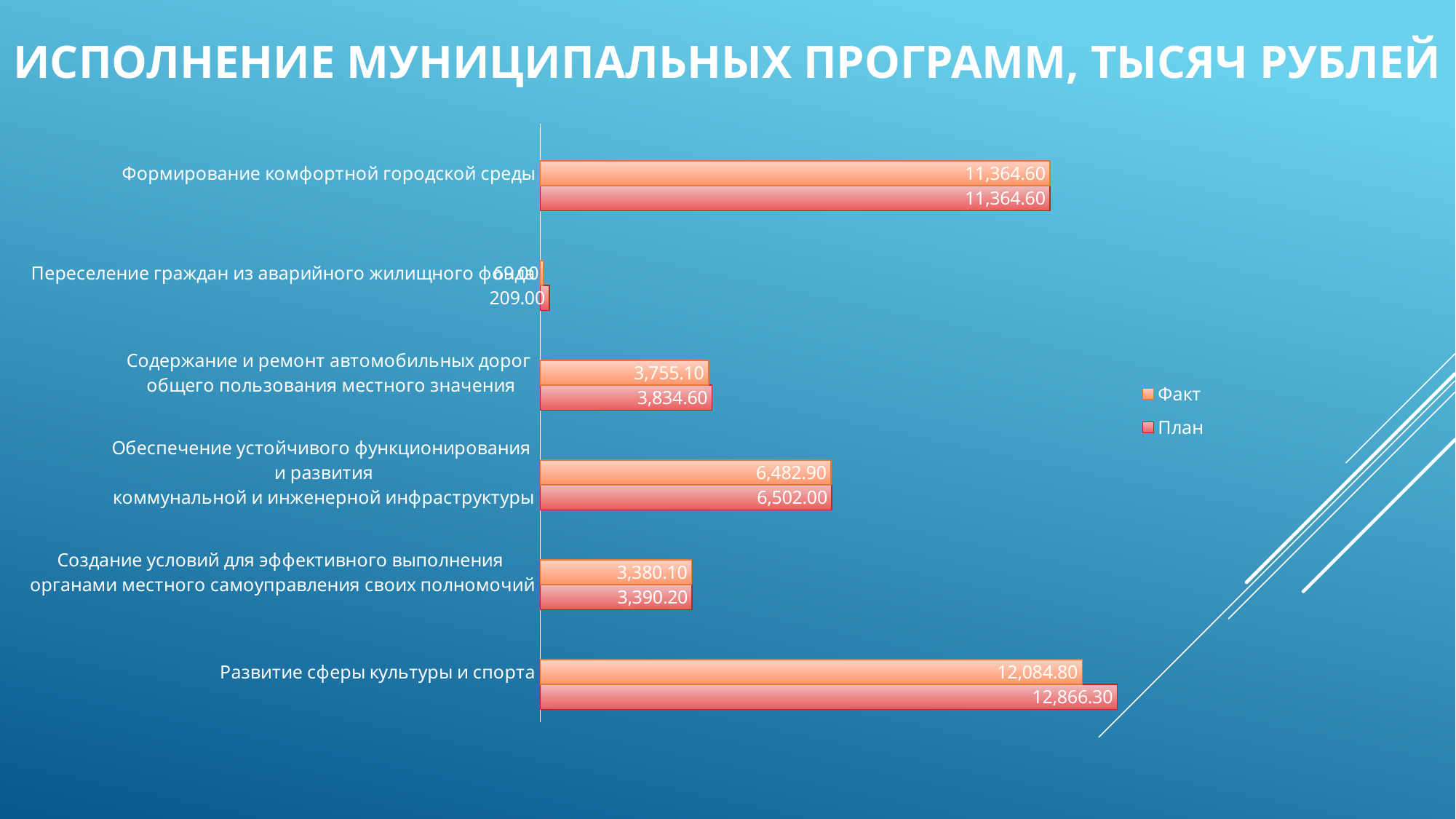
What is the difference between the План and Факт values for Развитие сферы культуры и спорта? 781.50 What is the Факт value for Развитие сферы культуры и спорта? 12,084.80 Which category has the lowest Факт value? Переселение граждан из аварийного жилищного фонда Which category has the highest План value? Развитие сферы культуры и спорта How many categories are shown in the chart? 6 How many series does the legend list? 2 What is the Факт value for Содержание и ремонт автомобильных дорог общего пользования местного значения? 3,755.10 What is the План value for Обеспечение устойчивого функционирования и развития коммунальной и инженерной инфраструктуры? 6,502.00 What is the difference between the План and Факт values for Содержание и ремонт автомобильных дорог общего пользования местного значения? 79.50 What is the План value for Переселение граждан из аварийного жилищного фонда? 209.00 Which is larger for Создание условий для эффективного выполнения органами местного самоуправления своих полномочий: the Факт value or the План value? План What is the План value for Развитие сферы культуры и спорта? 12,866.30